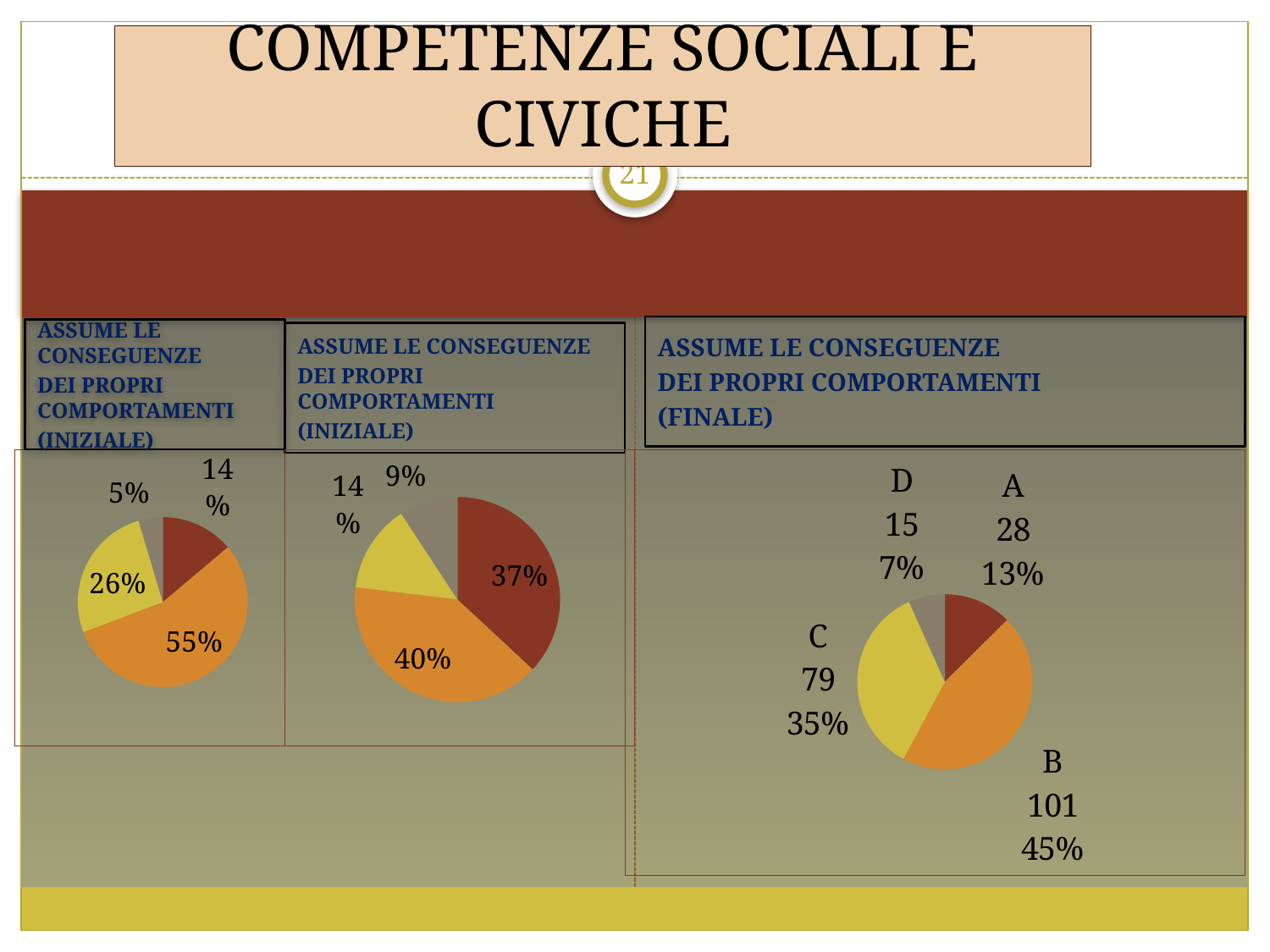
In the right-hand chart (FINALE), what percentage share does category C have? 35% In the right-hand chart (FINALE), what percentage share does category A have? 13% In the right-hand chart (FINALE), which category has the smallest slice? D How many slices does the right-hand chart (FINALE) have? 4 In the leftmost pie chart (INIZIALE), what is the percentage of the largest slice? 55% What kind of chart is used in the 'ASSUME LE CONSEGUENZE DEI PROPRI COMPORTAMENTI (FINALE)' chart on the right? Pie chart In the right-hand chart (FINALE), what is the value for category B? 101 In the right-hand chart (FINALE), which category has the largest slice? B In the right-hand chart (FINALE), which is larger, the value for A or the value for C? C In the right-hand chart (FINALE), what is the difference between the values for B and C? 22 In the middle pie chart (INIZIALE), what is the percentage of the smallest slice? 9% In the right-hand chart (FINALE), what is the value for category D? 15